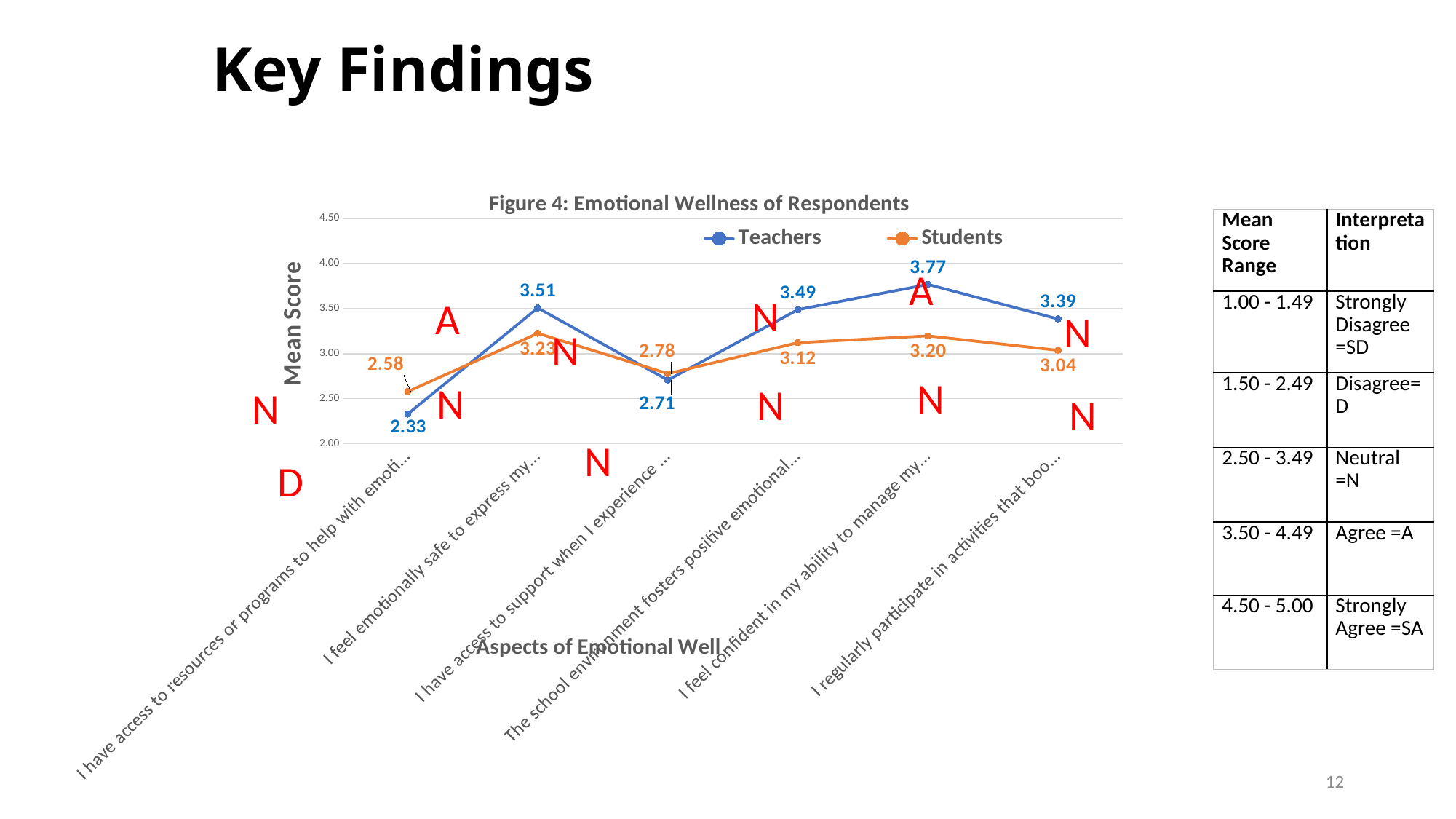
What is the Students mean score for the category beginning 'I have access to resources or programs to help with emoti...'? 2.58 What type of chart is Figure 4: Emotional Wellness of Respondents? Line chart Which category has the lowest Teachers mean score? I have access to resources or programs to help with emoti... What is the difference between the Teachers and Students mean scores for the category beginning 'I feel confident in my ability to manage my...'? 0.57 What is the label of the y axis in Figure 4? Mean Score For the category beginning 'I have access to support when I experience ...', which series has the larger mean score, Teachers or Students? Students How many series does the legend of Figure 4 list? 2 What is the Teachers mean score for the category beginning 'I feel emotionally safe to express my...'? 3.51 Which category has the highest Teachers mean score? I feel confident in my ability to manage my... How many categories are plotted along the x axis of Figure 4? 6 Is the Teachers mean score for the category beginning 'I feel confident in my ability to manage my...' greater or less than 3.50? greater What is the Students mean score for the category beginning 'I regularly participate in activities that boo...'? 3.04